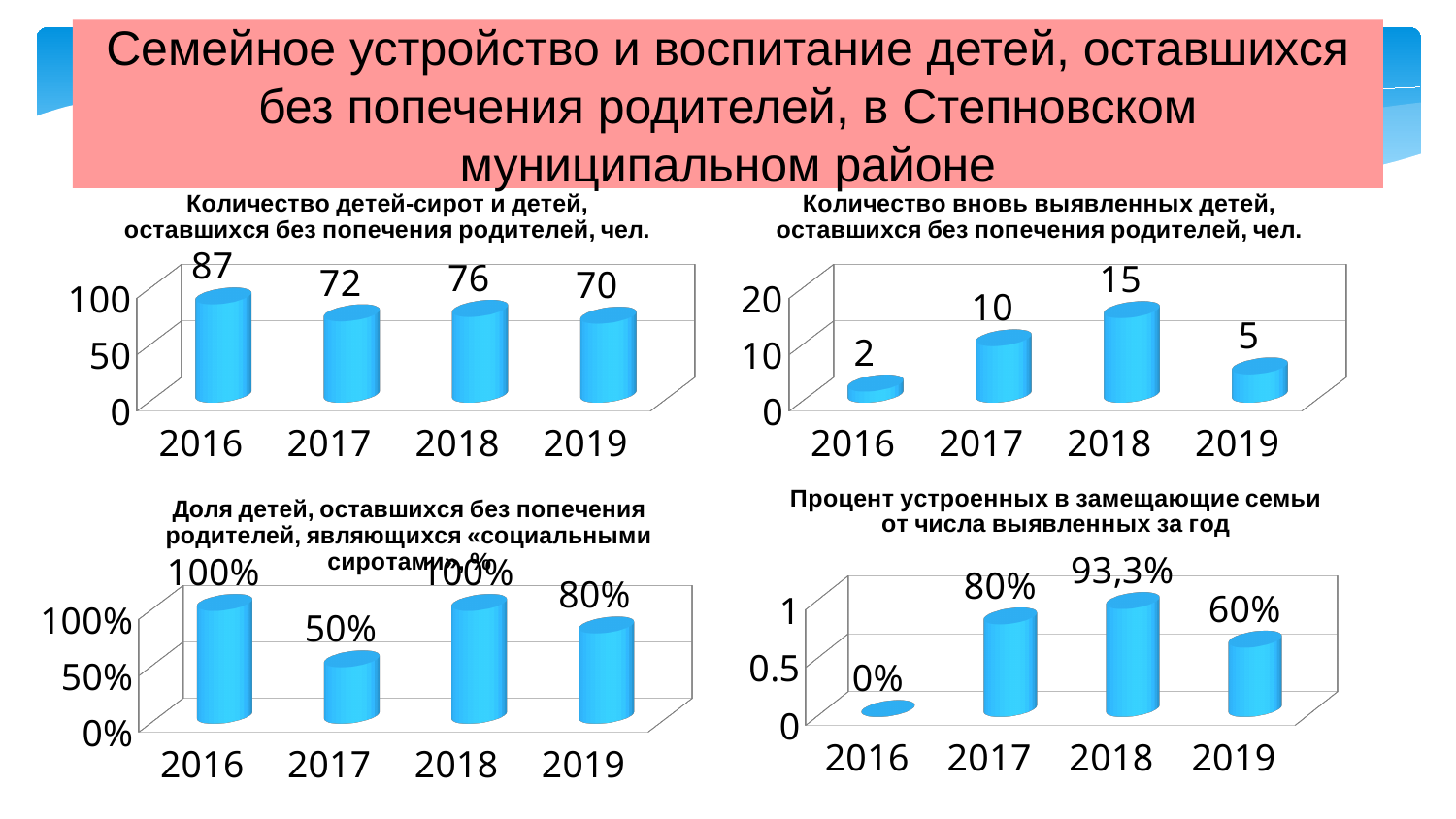
In the top-left chart (number of orphans and children left without parental care), what is the value for 2016? 87 In the top-right chart (number of newly identified children left without parental care), what is the value for 2018? 15 In the top-right chart (number of newly identified children left without parental care), which year has the highest value? 2018 In the bottom-right chart (percent placed in substitute families), what is the value for 2018? 93,3% In the bottom-left chart (share of children who are 'social orphans'), what is the value for 2019? 80% How many years are shown on the x axis of the top-left chart? 4 In the top-left chart (number of orphans and children left without parental care), which year has the lowest value? 2019 In the bottom-left chart (share of children who are 'social orphans'), what is the value for 2017? 50% In the top-right chart (number of newly identified children left without parental care), which is larger: the value for 2017 or the value for 2019? 2017 In the top-left chart (number of orphans and children left without parental care), what is the difference between the 2016 and 2019 values? 17 What type of chart is the top-right chart (number of newly identified children)? Bar chart In the bottom-right chart (percent placed in substitute families), which year has the lowest value? 2016